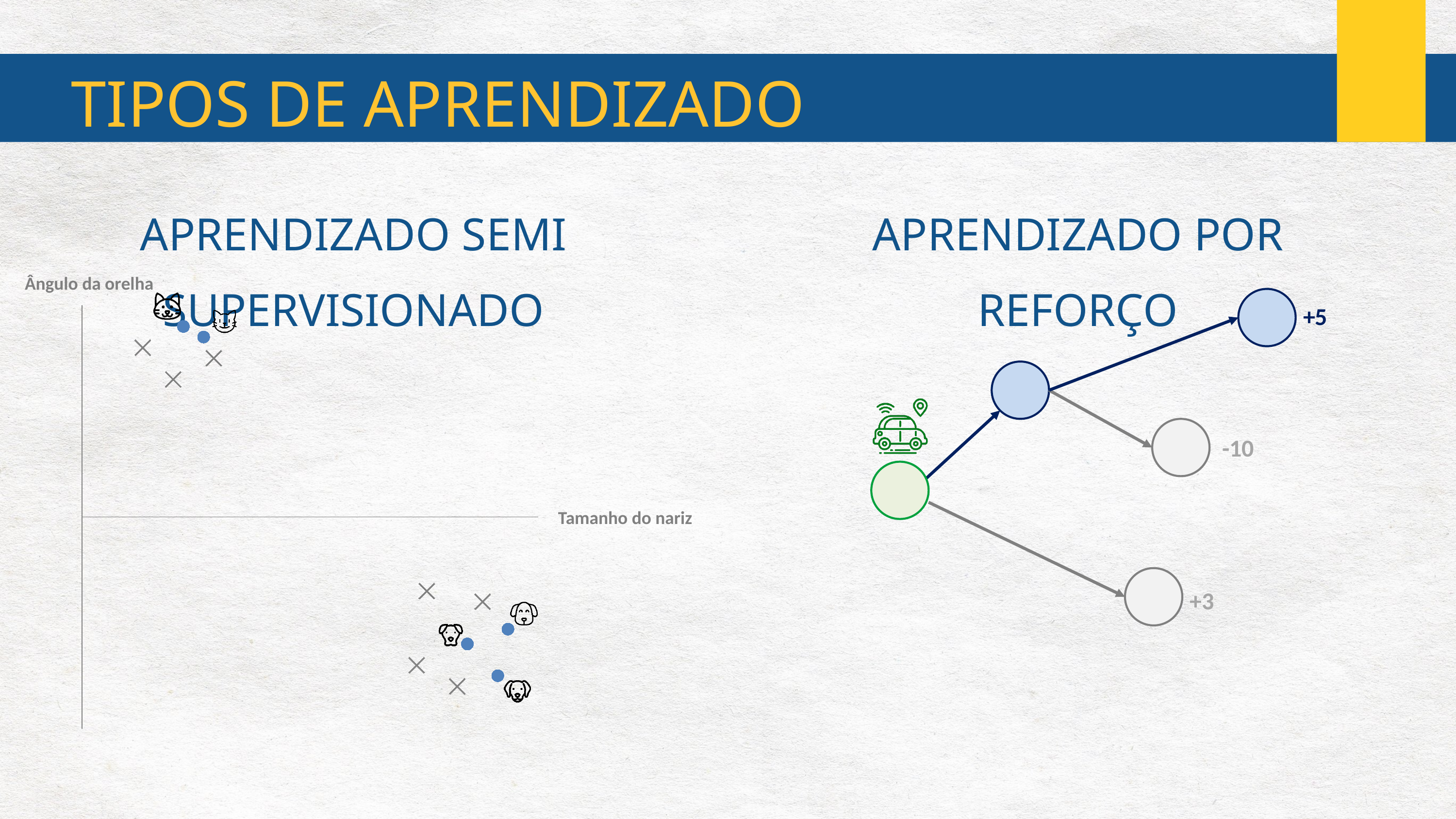
What kind of chart is shown on the left side of the slide under 'Aprendizado semi supervisionado'? scatter plot On the left scatter plot, how many separate clusters of points are shown? 2 In the reinforcement learning diagram on the right, what reward value is shown next to the top-right node? +5 In the reinforcement learning diagram on the right, what reward value is shown next to the middle-right node? -10 On the left scatter plot, what is the label of the vertical axis? Ângulo da orelha On the left scatter plot, how many X markers are plotted? 7 On the left scatter plot, what is the label of the horizontal axis? Tamanho do nariz In the reinforcement learning diagram on the right, what reward value is shown next to the bottom-right node? +3 In the reinforcement learning diagram on the right, which node has the highest reward value? the top-right node (+5) In the reinforcement learning diagram on the right, what is the difference between the highest reward (+5) and the lowest reward (-10)? 15 In the reinforcement learning diagram on the right, which node has the lowest reward value? the middle-right node (-10) On the left scatter plot, how many blue filled dots are plotted? 5